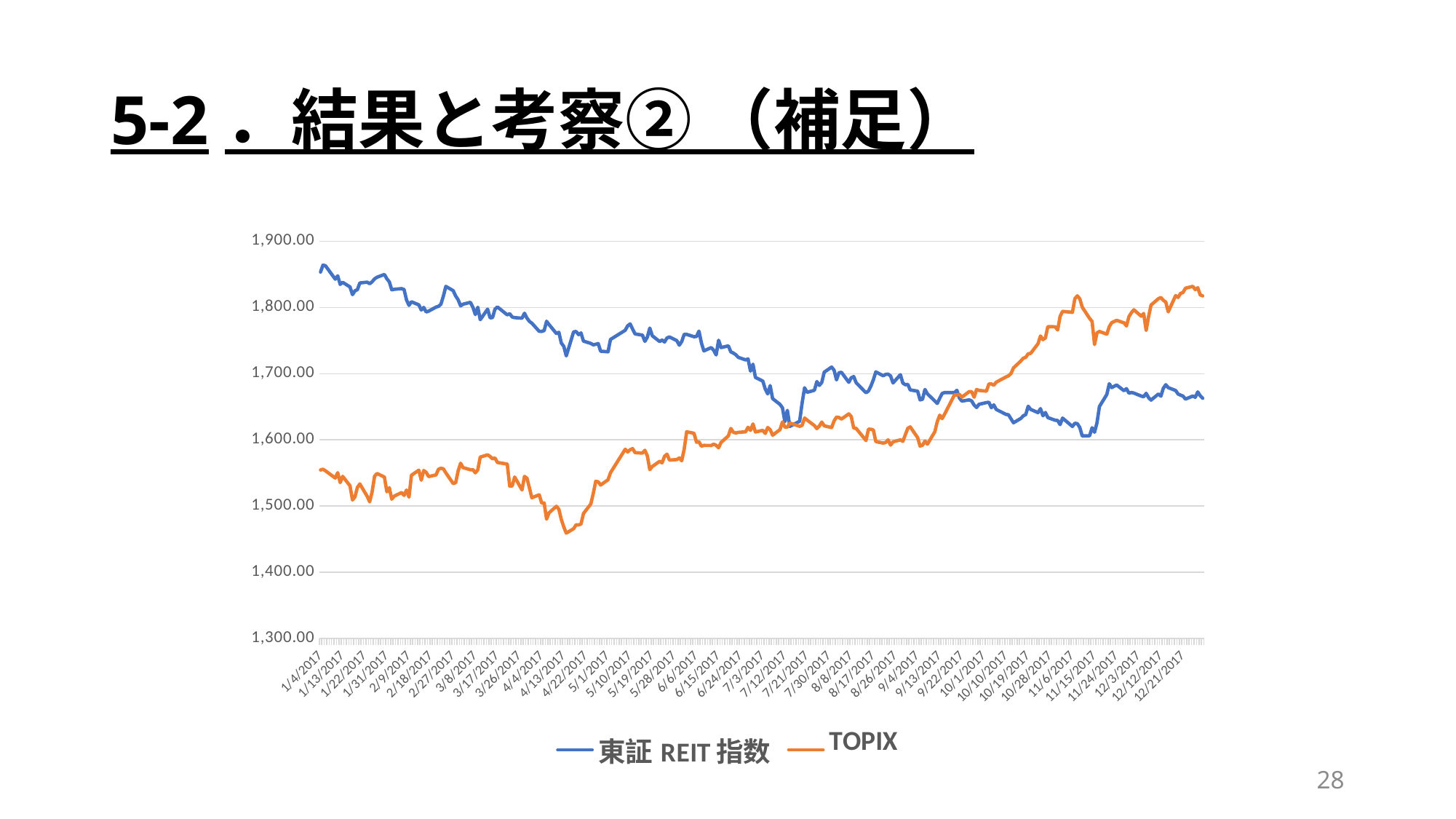
At 1/4/2017, which series has the higher value, 東証 REIT 指数 or TOPIX? 東証 REIT 指数 What kind of chart is shown on the slide? line chart Which two series are listed in the legend? 東証 REIT 指数 and TOPIX Is the value of TOPIX at 12/21/2017 greater or less than 1,800.00? greater At 12/21/2017, which series has the higher value, 東証 REIT 指数 or TOPIX? TOPIX Which colour is used for the TOPIX line? orange Does the 東証 REIT 指数 line generally rise or fall from 1/4/2017 to 12/21/2017? fall Is the lowest point of the TOPIX line (around 4/13/2017) greater or less than 1,500.00? less Is the value of TOPIX at 1/4/2017 greater or less than 1,600.00? less How many series does the legend list? 2